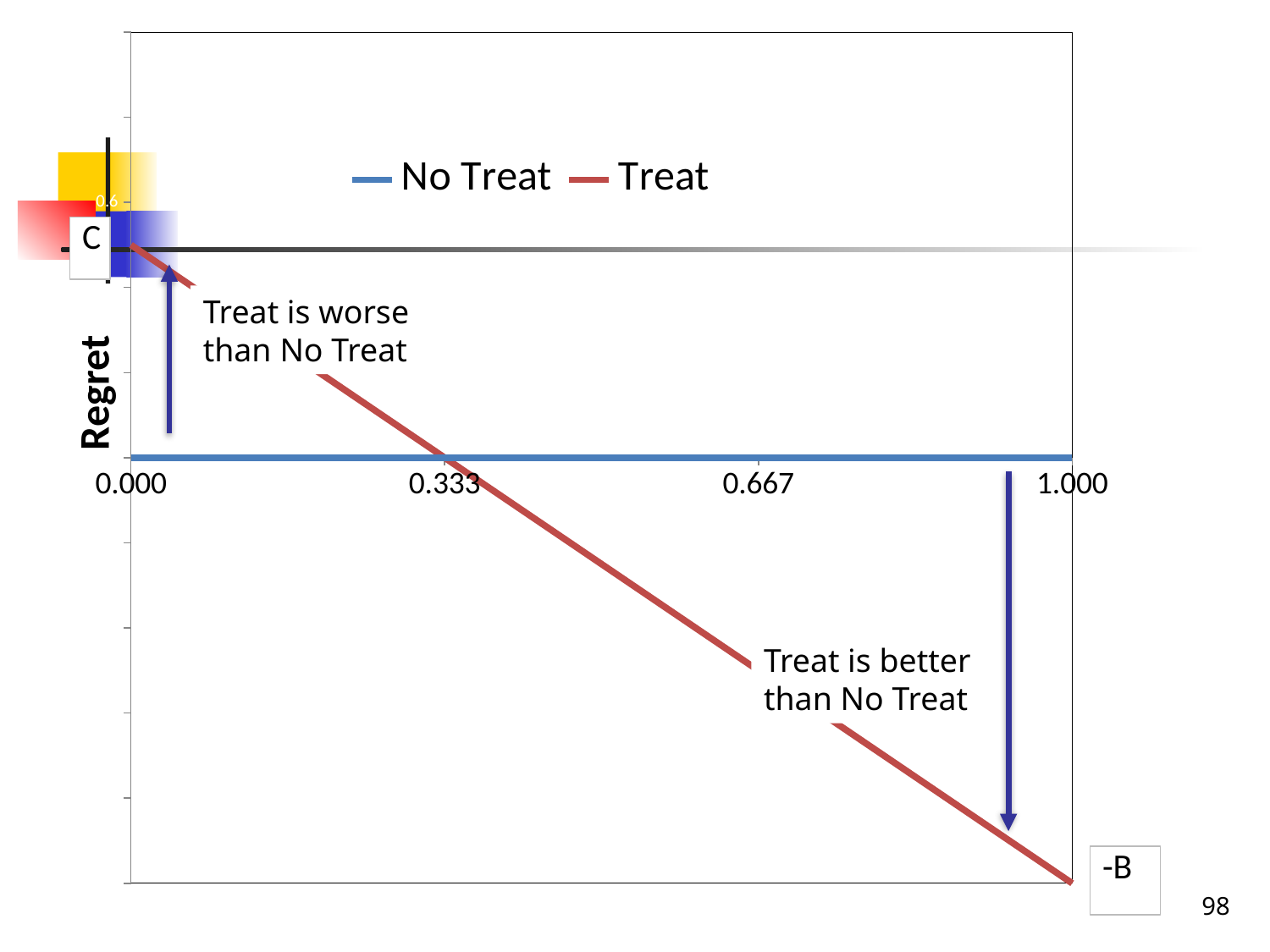
Does the No Treat line rise, fall, or stay flat across the x axis? stay flat At x = 1.000, which series has the higher regret, Treat or No Treat? No Treat At x = 0.000, which series has the higher regret, Treat or No Treat? Treat What is the label on the vertical axis? Regret What kind of chart is shown on the slide? line chart What is the largest tick label shown on the x axis? 1.000 What are the two series named in the legend? No Treat and Treat How many tick labels are shown on the x axis? 4 How many series does the legend list? 2 What label marks the value of the Treat line at x = 0.000? C Does the Treat line rise or fall as the x value increases from 0.000 to 1.000? fall What label marks the value of the Treat line at x = 1.000? -B